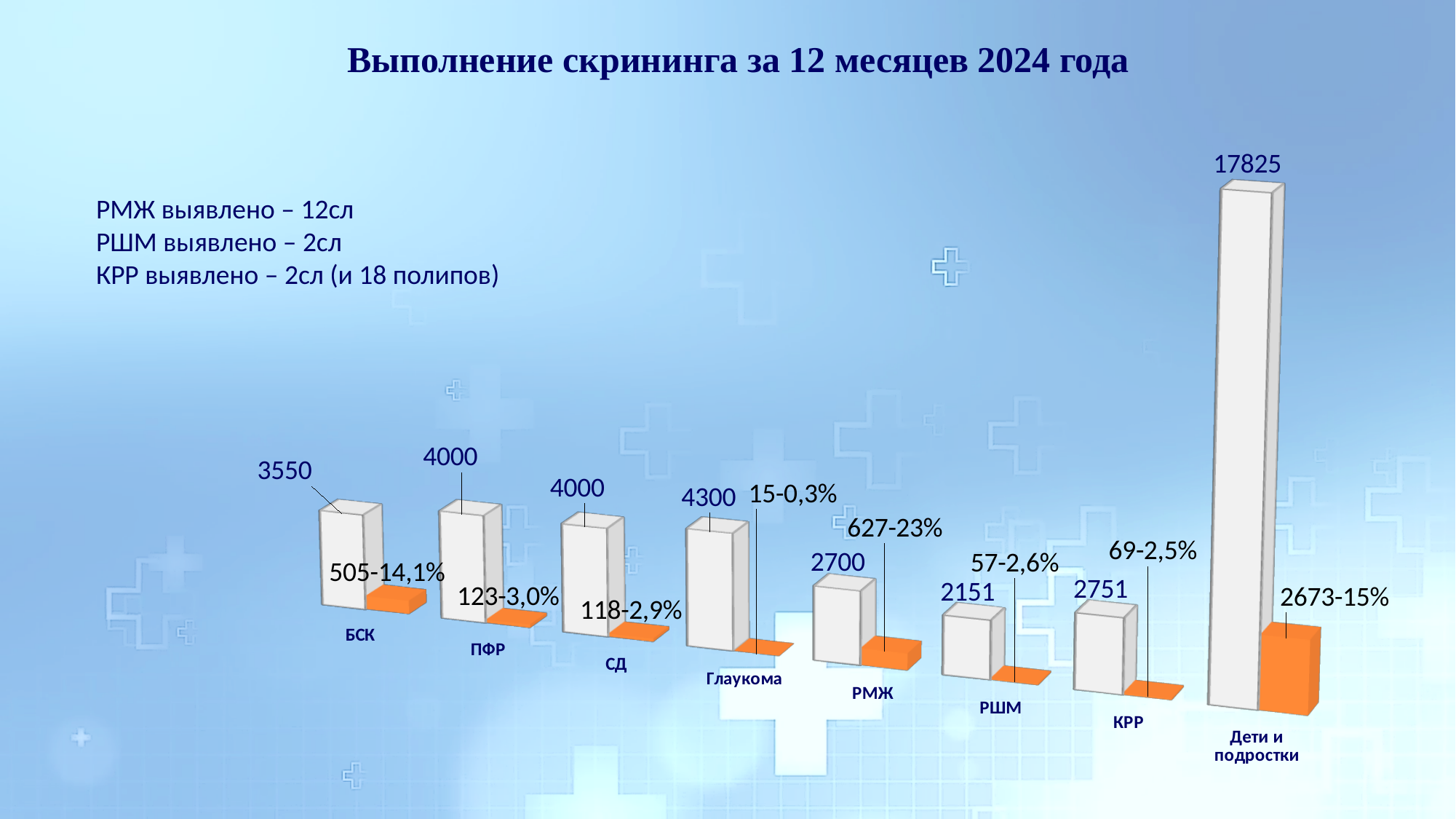
Which category has the highest grey bar? Дети и подростки What is the title of the chart? Выполнение скрининга за 12 месяцев 2024 года What kind of chart is shown on the slide? Bar chart Which category has the lowest grey bar? РШМ What is the difference between the grey bar values for Глаукома and РМЖ? 1600 What is the value of the grey bar for БСК? 3550 What is the value of the grey bar for Дети и подростки? 17825 Which grey bar is larger, КРР or РШМ? КРР What is the value of the grey bar for РШМ? 2151 What label is shown on the orange bar for РМЖ? 627-23% What label is shown on the orange bar for Глаукома? 15-0,3% How many categories are shown on the x axis? 8